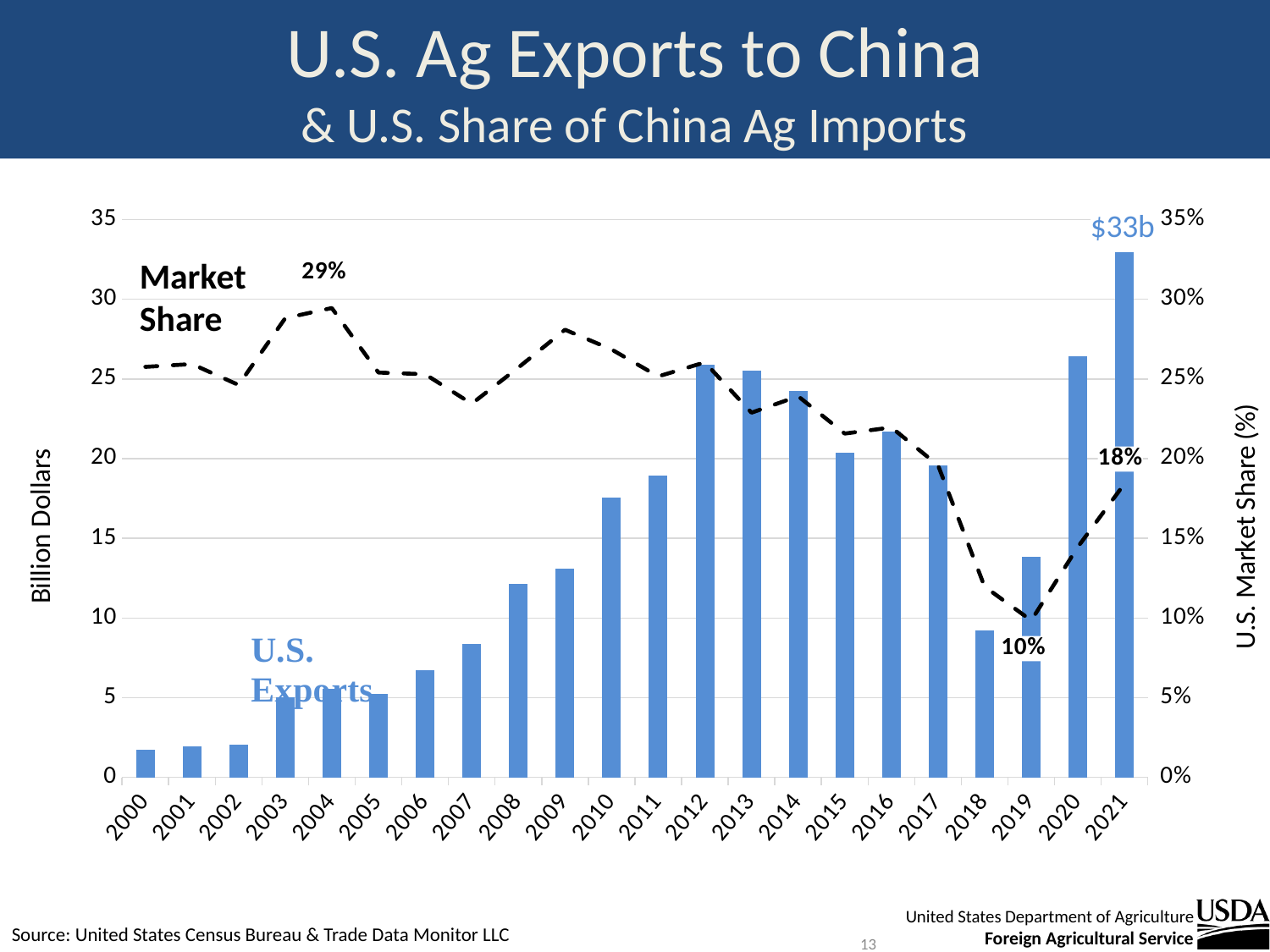
What is the value of U.S. ag exports to China in 2021? $33b Which year had larger U.S. ag exports to China, 2012 or 2019? 2012 How many years are shown on the x axis of the chart? 22 What is the label on the right-hand vertical axis? U.S. Market Share (%) Is the value of U.S. ag exports to China in 2010 greater or less than 15 billion dollars? greater In which year was the U.S. market share of China ag imports lowest? 2019 By how many percentage points did the U.S. market share fall from its 2004 value to its 2019 value? 19 percentage points How did U.S. ag exports to China change from 2000 to 2012? They rose What was the U.S. market share of China ag imports in 2019? 10% What was the U.S. market share of China ag imports in 2004? 29% Which year has the highest U.S. ag exports to China? 2021 What was the U.S. market share of China ag imports in 2021? 18%